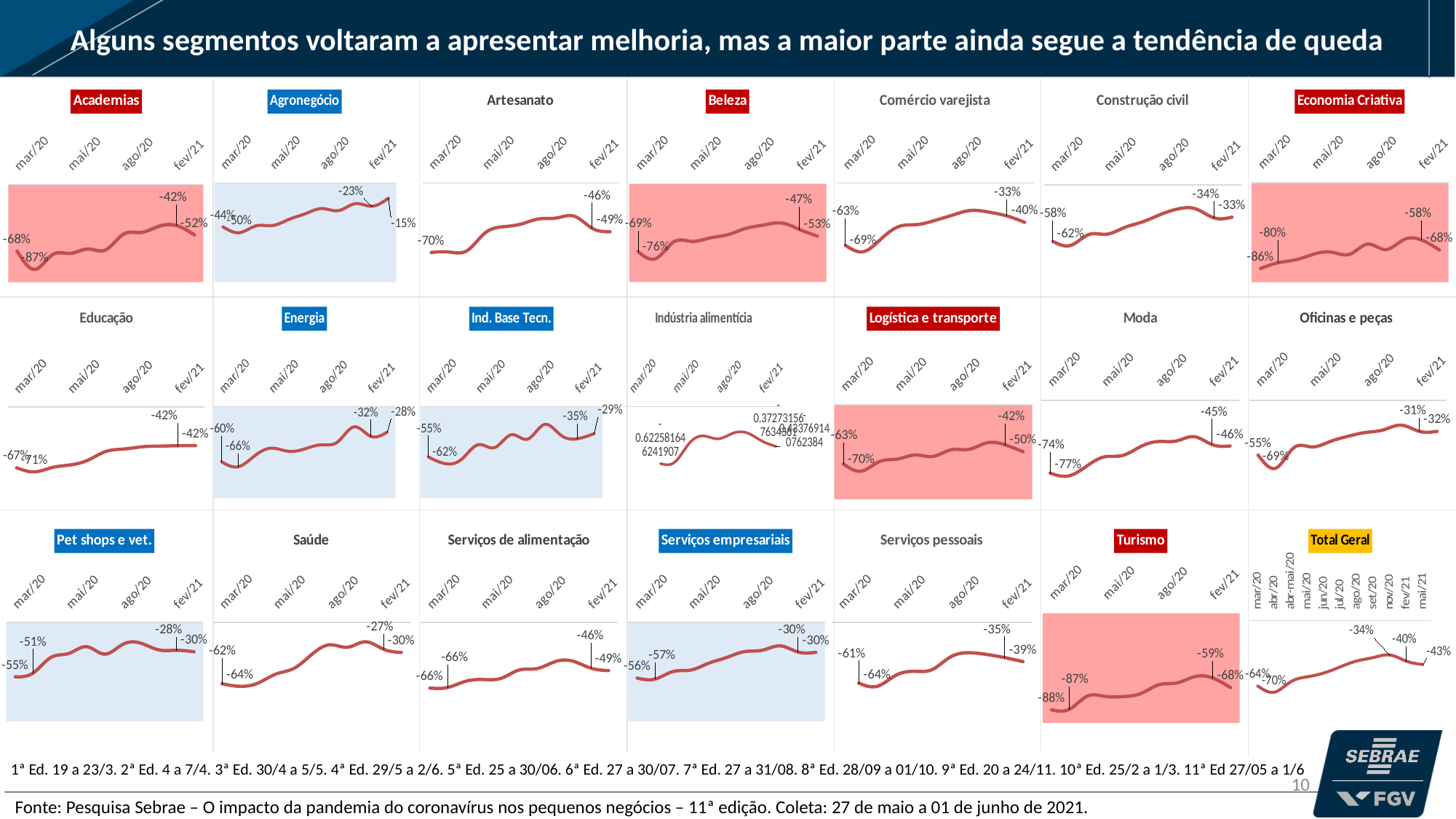
Which is higher at the last point (fev/21): Energia at -28% or Beleza at -53%? Energia In the Moda chart, what is the lowest value labelled on the line? -77% In the Agronegócio chart, what is the value at the last point (fev/21)? -15% Which segment chart has a yellow title highlight? Total Geral In the Logística e transporte chart, does the line rise or fall between the peak labelled -42% and the last point labelled -50%? fall In the Saúde chart, what is the difference between the peak value of -27% and the final value of -30%? 3 percentage points In the Comércio varejista chart, what is the value labelled at the first point (mar/20)? -63% What kind of chart is used for each segment on the slide? line chart In the Total Geral chart, what is the value labelled at the last point? -43% In the Turismo chart, what is the value labelled at the first point (mar/20)? -88% In the Economia Criativa chart, what is the value labelled at the last point (fev/21)? -68% In the Academias chart, what is the lowest value labelled on the line? -87%